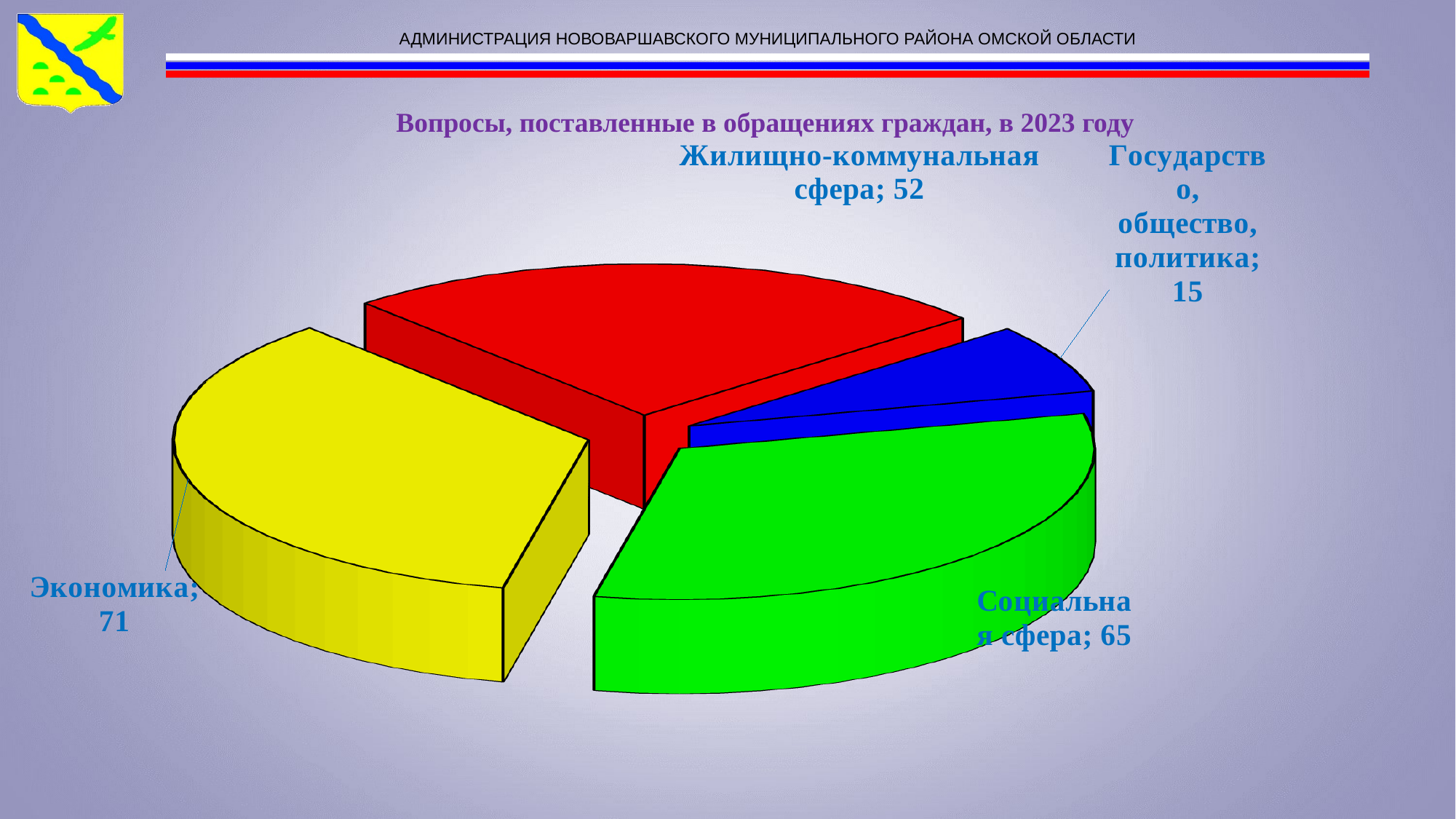
Which category has the lowest value? Государство, общество, политика Which is larger: Жилищно-коммунальная сфера or Социальная сфера? Социальная сфера What is the value for Социальная сфера? 65 What is the title of the chart? Вопросы, поставленные в обращениях граждан, в 2023 году Which category has the highest value? Экономика What is the value for Жилищно-коммунальная сфера? 52 What is the value for Государство, общество, политика? 15 How many slices does the pie chart have? 4 What type of chart is shown on the slide? Pie chart What is the difference between the values for Экономика and Социальная сфера? 6 What is the value for Экономика? 71 What colour is the slice for Экономика? Yellow